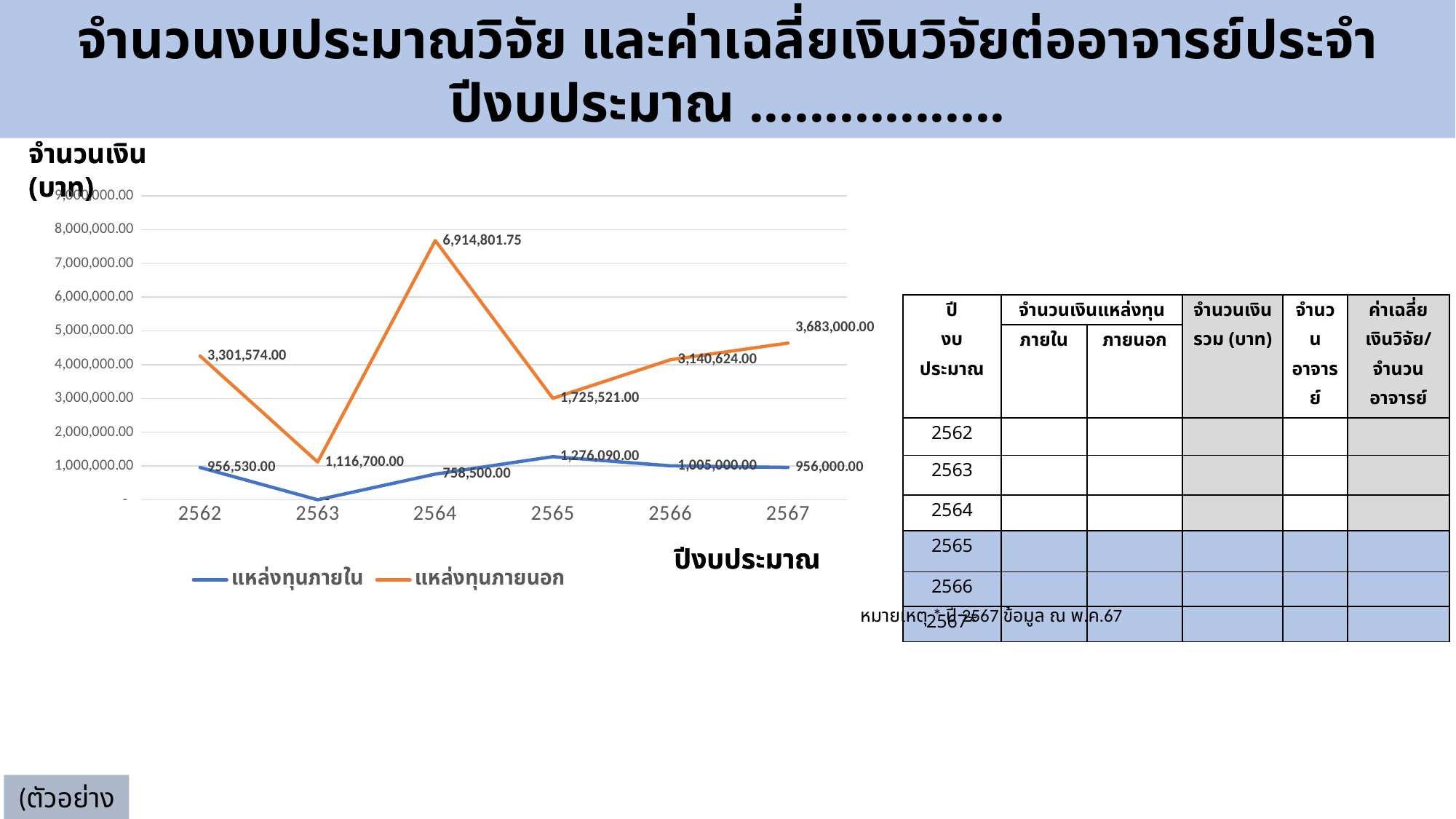
Does the แหล่งทุนภายนอก line rise or fall from 2565 to 2567? rise What is the value labelled for แหล่งทุนภายใน in 2565? 1,276,090.00 What is the difference between the แหล่งทุนภายนอก values for 2567 and 2566? 542,376.00 How many fiscal years are shown on the x axis of the chart? 6 What is the value labelled for แหล่งทุนภายนอก in 2564? 6,914,801.75 In which year is the labelled value for แหล่งทุนภายนอก lowest? 2563 What colour is the line for แหล่งทุนภายนอก? orange What type of chart is shown on the slide? line chart Which is larger, the แหล่งทุนภายใน value for 2566 or for 2567? 2566 What is the value labelled for แหล่งทุนภายนอก in 2567? 3,683,000.00 How many series does the chart legend list? 2 In which year is the labelled value for แหล่งทุนภายนอก highest? 2564